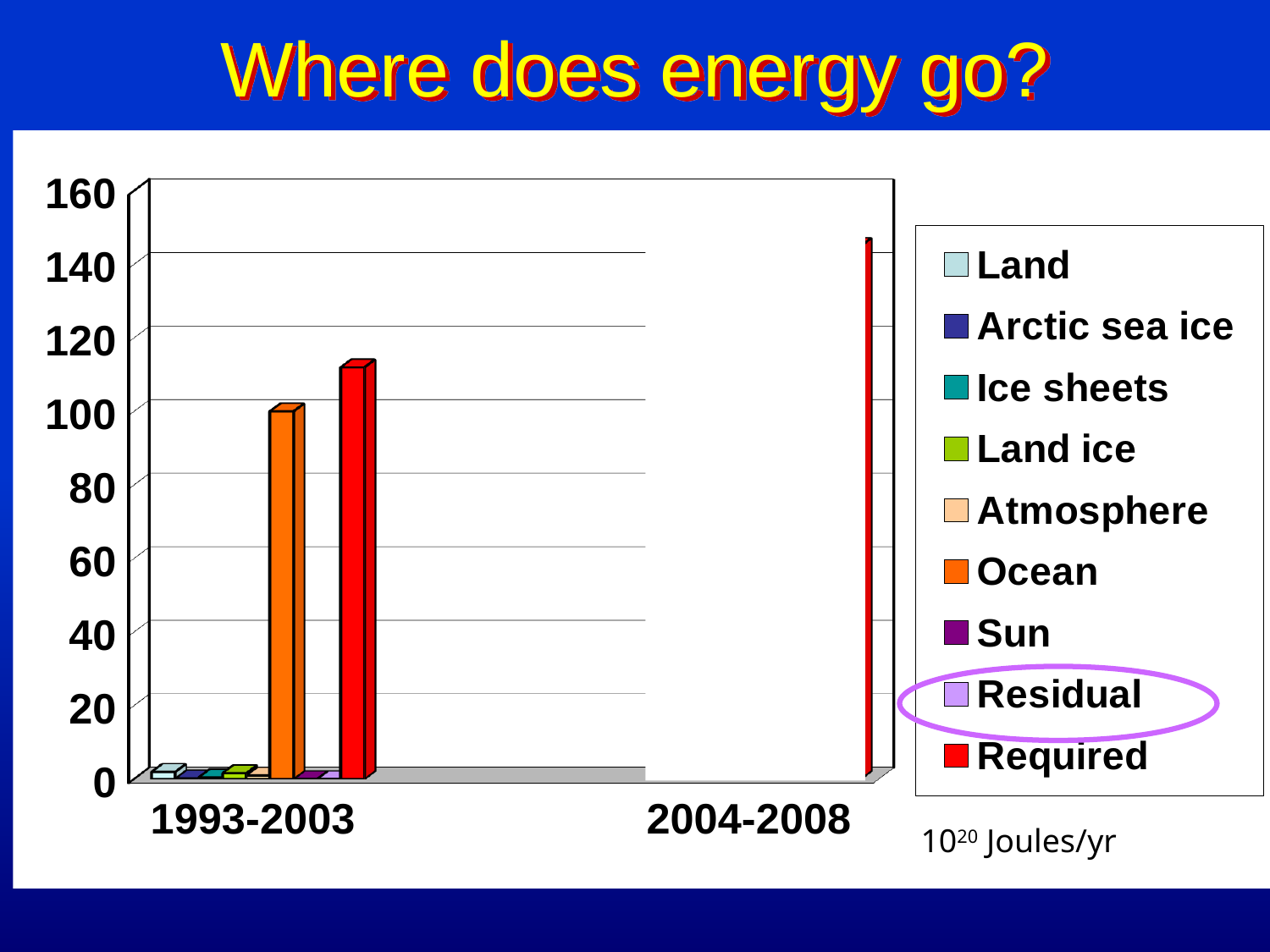
Is the value for Required in 1993-2003 greater or less than 100? greater Which legend entry is circled on the slide? Residual What is the title of the slide containing the chart? Where does energy go? What kind of chart is shown on the slide? bar chart In the 1993-2003 category, which is larger: Ocean or Required? Required Is the value for Land in 1993-2003 greater or less than 20? less Is the value for Ocean in 1993-2003 greater or less than 80? greater Is the Required value for 2004-2008 larger or smaller than the Required value for 1993-2003? larger How many series does the chart's legend list? 9 Which series has the highest value in the 1993-2003 category? Required How many categories are shown on the x axis of the chart? 2